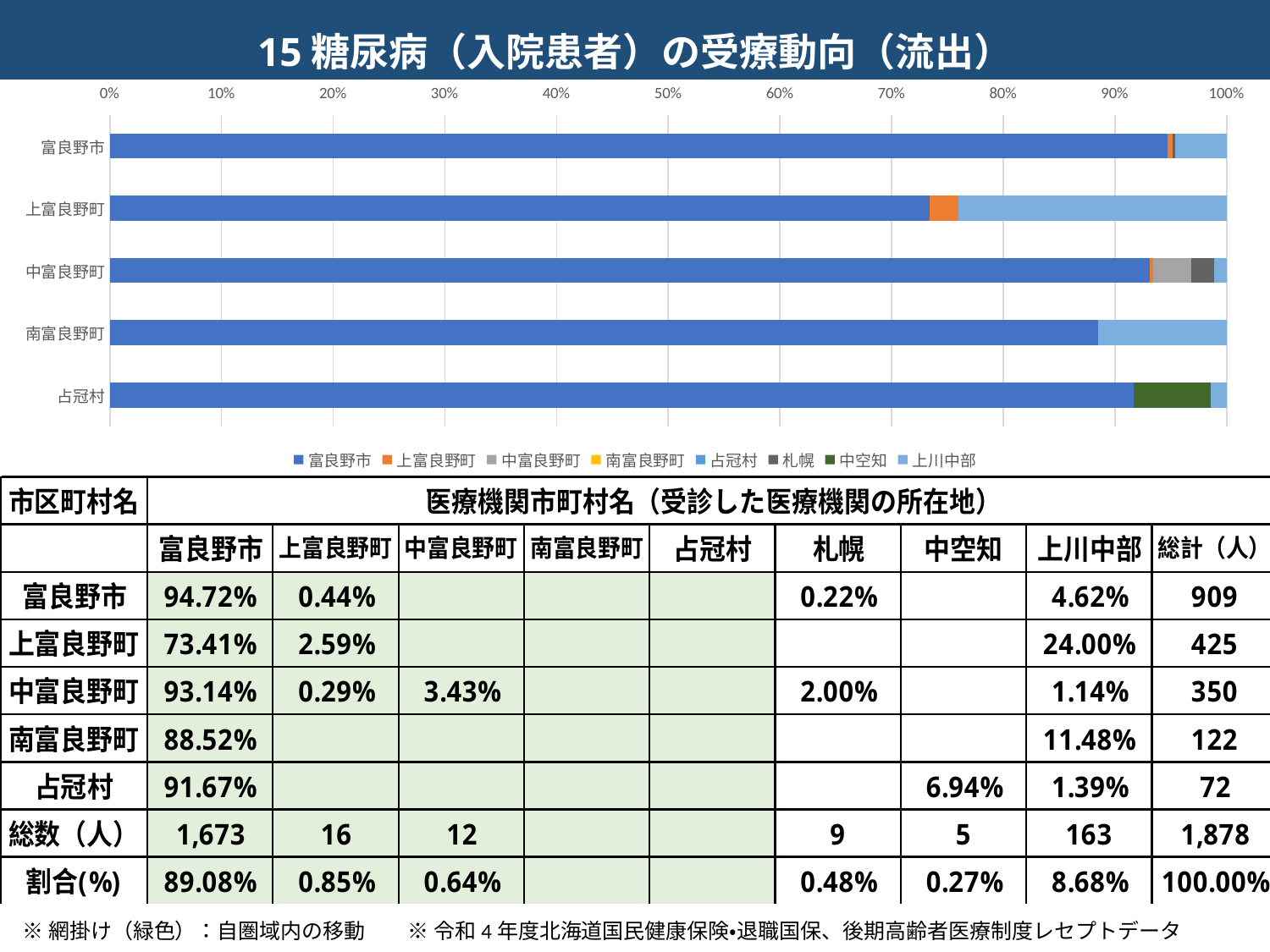
Is the 富良野市 share for 上富良野町 greater or less than 80%? less What is the title of the chart on the slide? 15 糖尿病（入院患者）の受療動向（流出） How many municipalities (categories) are plotted on the y axis of the chart? 5 According to the slide, what share of 富良野市 inpatients received care in 富良野市? 94.72% What is the difference between the 富良野市 share for 富良野市 (94.72%) and for 南富良野町 (88.52%)? 6.20% What share of 上富良野町 inpatients received care in 上川中部? 24.00% How many series does the chart legend list? 8 What share of 占冠村 inpatients received care in 中空知? 6.94% What kind of chart is shown on the slide? stacked bar chart Which is larger: the 上川中部 share for 南富良野町 or for 中富良野町? 南富良野町 Which municipality has the lowest share of inpatients treated in 富良野市? 上富良野町 Which municipality has the highest share of inpatients treated in 富良野市? 富良野市